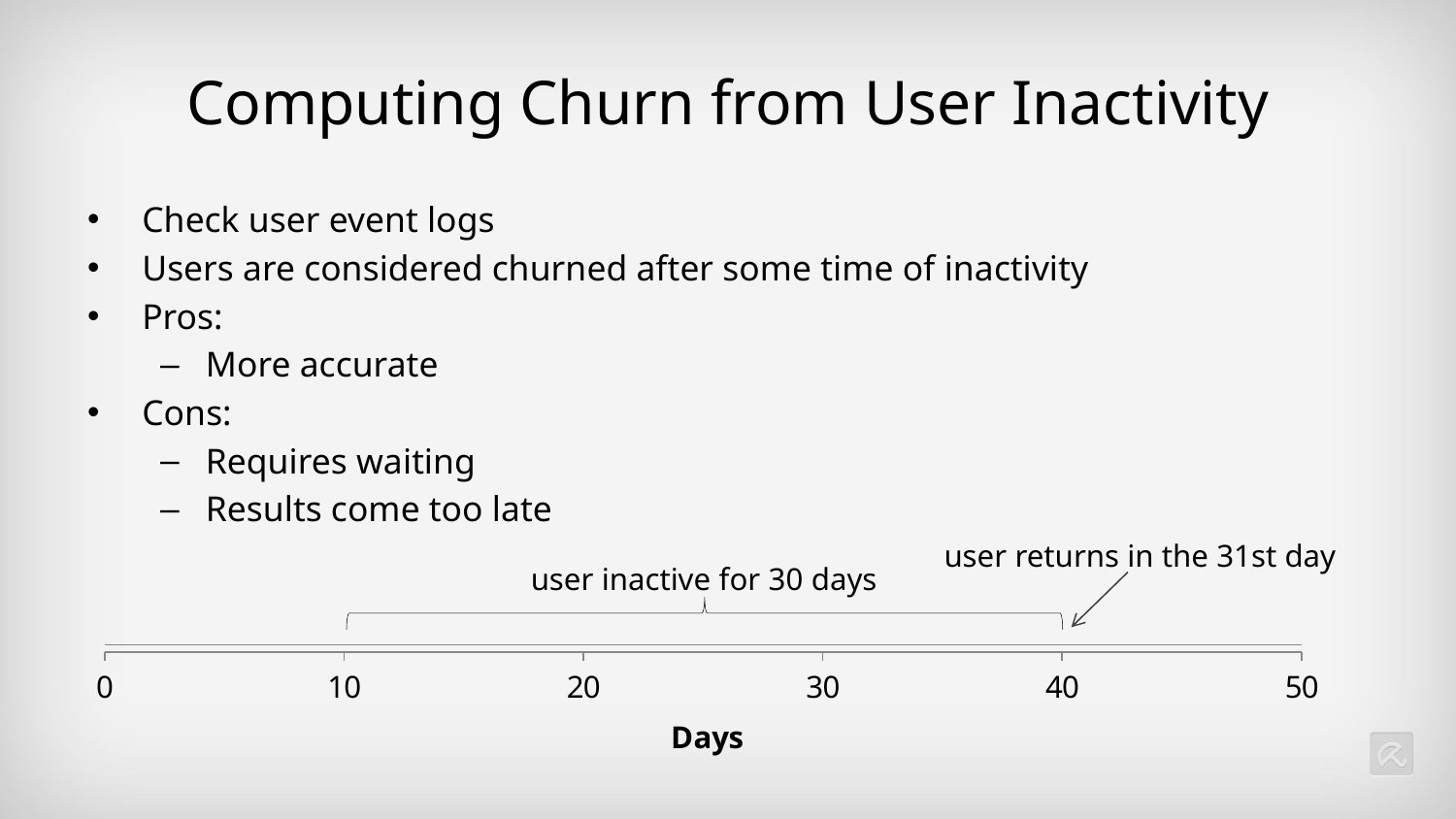
At which tick on the Days axis does the 'user inactive for 30 days' bracket begin? 10 What is the highest tick value shown on the Days axis? 50 At which tick on the Days axis does the 'user inactive for 30 days' bracket end? 40 According to the annotation on the timeline, on which day does the user return? the 31st day According to the bracket annotation on the timeline, for how many days is the user inactive? 30 days What is the label of the horizontal axis on the timeline at the bottom of the slide? Days How many labelled ticks are there on the Days axis? 6